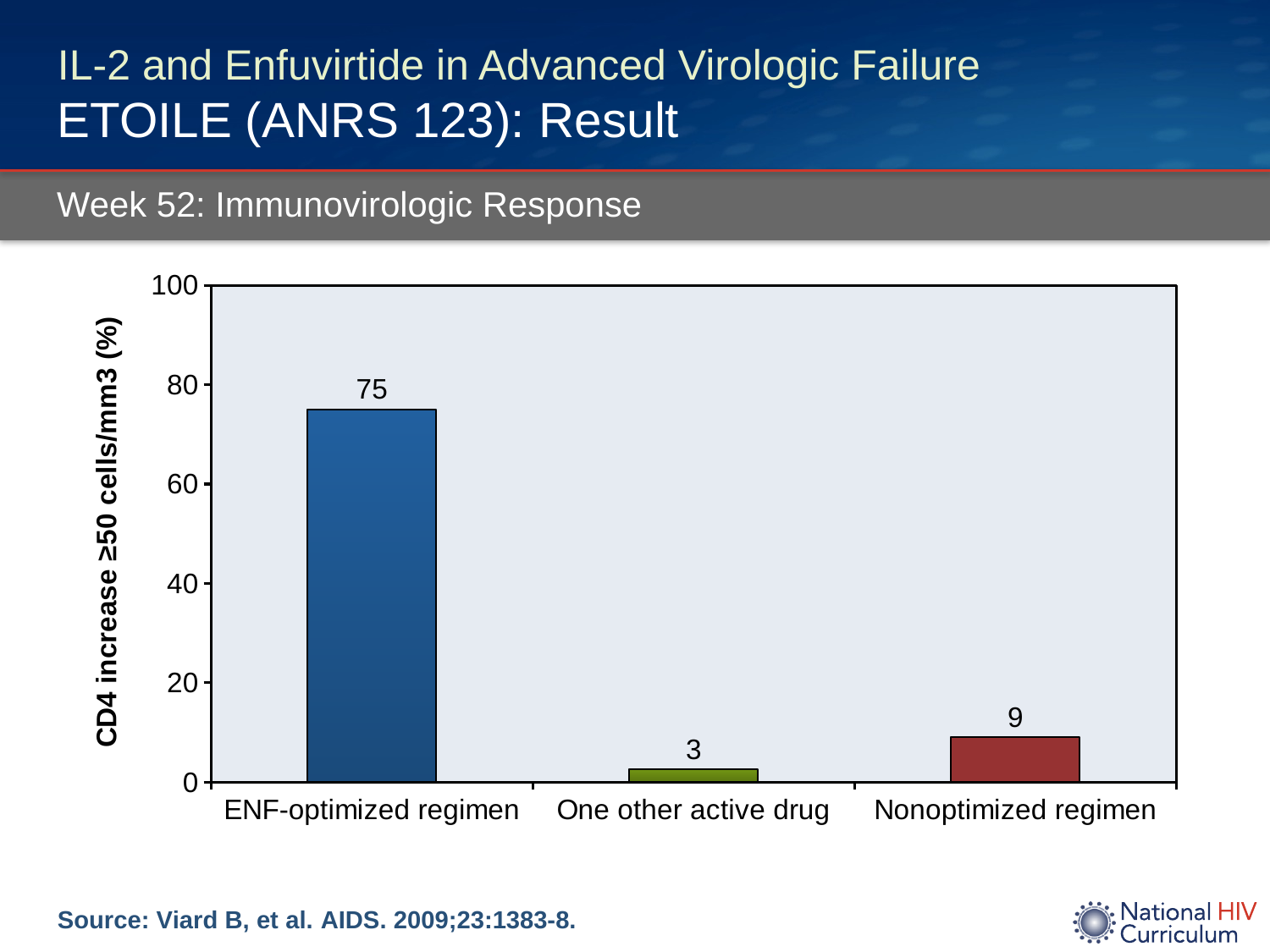
Which is larger, the value for Nonoptimized regimen or the value for One other active drug? Nonoptimized regimen What is the value for Nonoptimized regimen? 9 What is the difference between the values for Nonoptimized regimen and One other active drug? 6 Which category has the lowest value? One other active drug Which category has the highest value? ENF-optimized regimen What is the difference between the values for ENF-optimized regimen and Nonoptimized regimen? 66 What kind of chart is shown on the slide? bar chart What is the value for ENF-optimized regimen? 75 Is the value for ENF-optimized regimen greater or less than 60? greater What is the value for One other active drug? 3 How many categories are shown on the x axis? 3 What is the label of the y axis? CD4 increase ≥50 cells/mm3 (%)